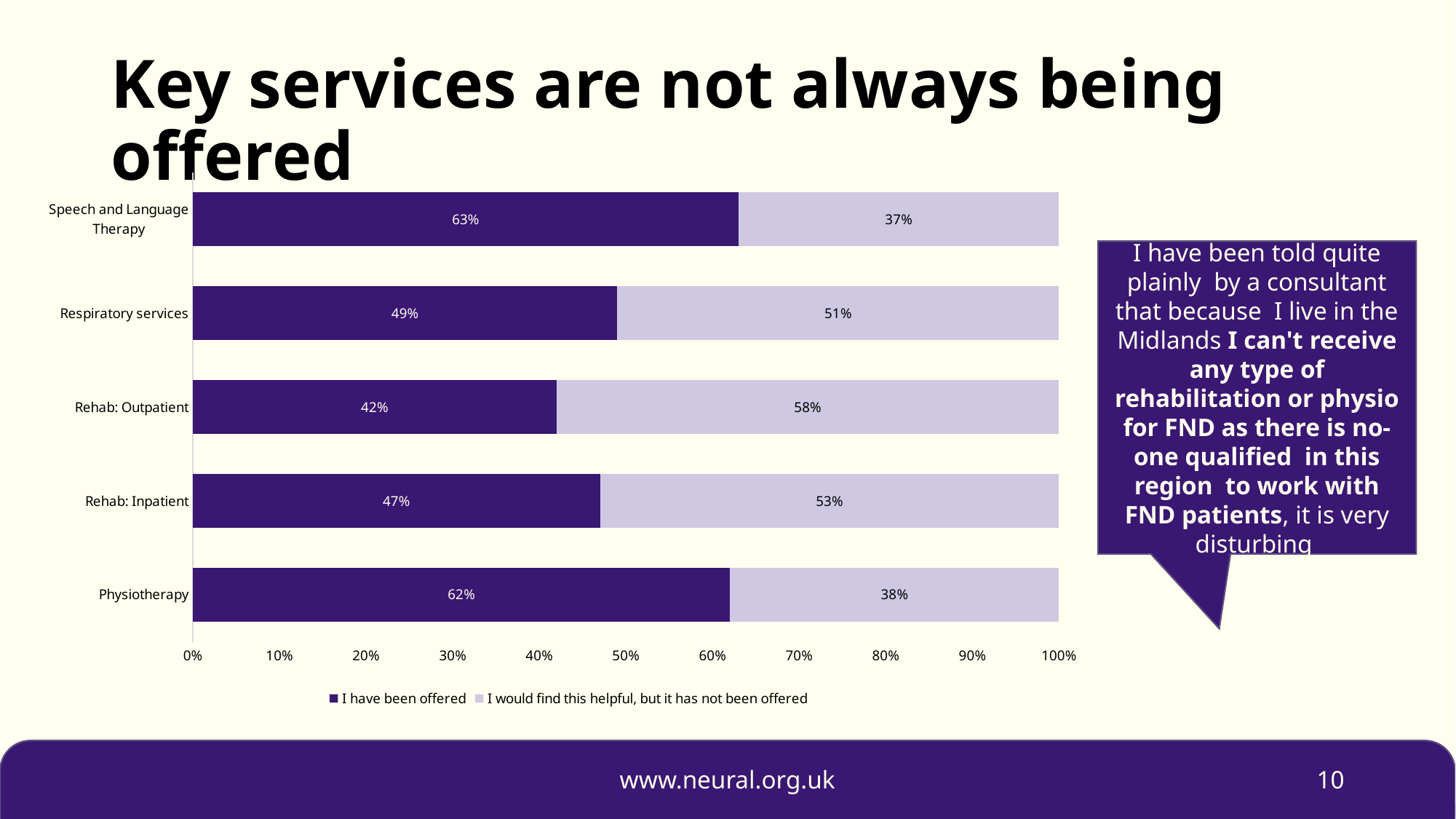
What is the total of the two segments for the Rehab: Inpatient bar? 100% What percentage of respondents said they have been offered Speech and Language Therapy? 63% What kind of chart is shown on the slide? Stacked bar chart Which service has the lowest 'I have been offered' percentage? Rehab: Outpatient Which service has the highest 'I have been offered' percentage? Speech and Language Therapy What percentage of respondents would find Respiratory services helpful but have not been offered them? 51% How many services are shown in the chart? 5 What is the difference between the 'I have been offered' values for Physiotherapy and Rehab: Inpatient? 15% What is the 'I would find this helpful, but it has not been offered' value for Physiotherapy? 38% How many series does the legend list? 2 What is the 'I have been offered' value for Rehab: Outpatient? 42% Which has a larger 'I have been offered' value, Respiratory services or Rehab: Inpatient? Respiratory services